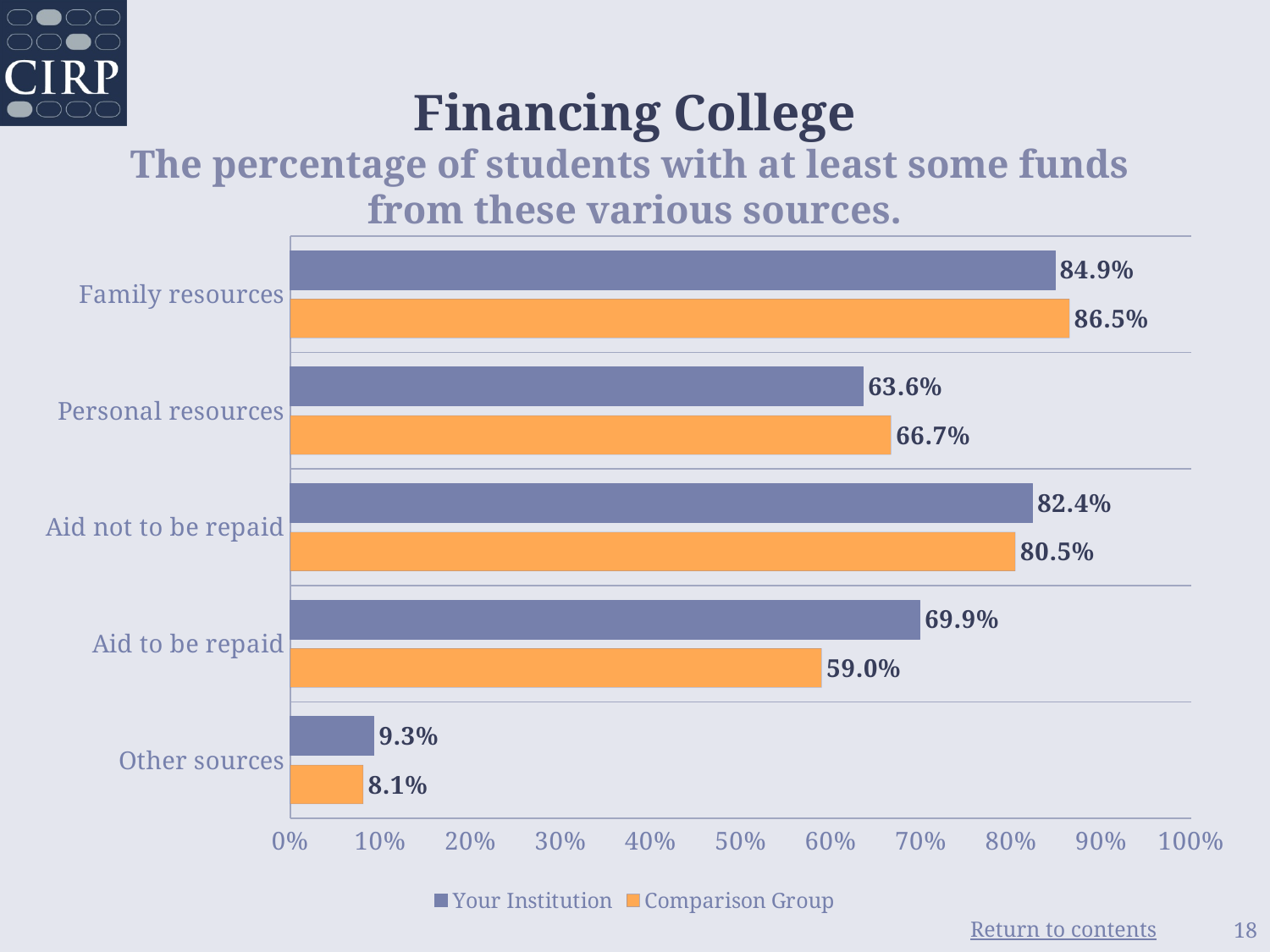
For Personal resources, which is larger: Your Institution or the Comparison Group? Comparison Group Which source has the highest Comparison Group percentage? Family resources Is the Your Institution value for Aid not to be repaid greater or less than 80%? greater Which colour represents the Comparison Group in the chart? Orange What is the Comparison Group value for Aid to be repaid? 59.0% What kind of chart is shown on the slide? Bar chart What percentage of students at Your Institution have at least some funds from Family resources? 84.9% How many funding sources are shown on the chart? 5 What is the Your Institution value for Other sources? 9.3% How many series does the legend list? 2 Which source has the lowest Your Institution percentage? Other sources What is the difference between Your Institution and the Comparison Group for Aid to be repaid? 10.9%